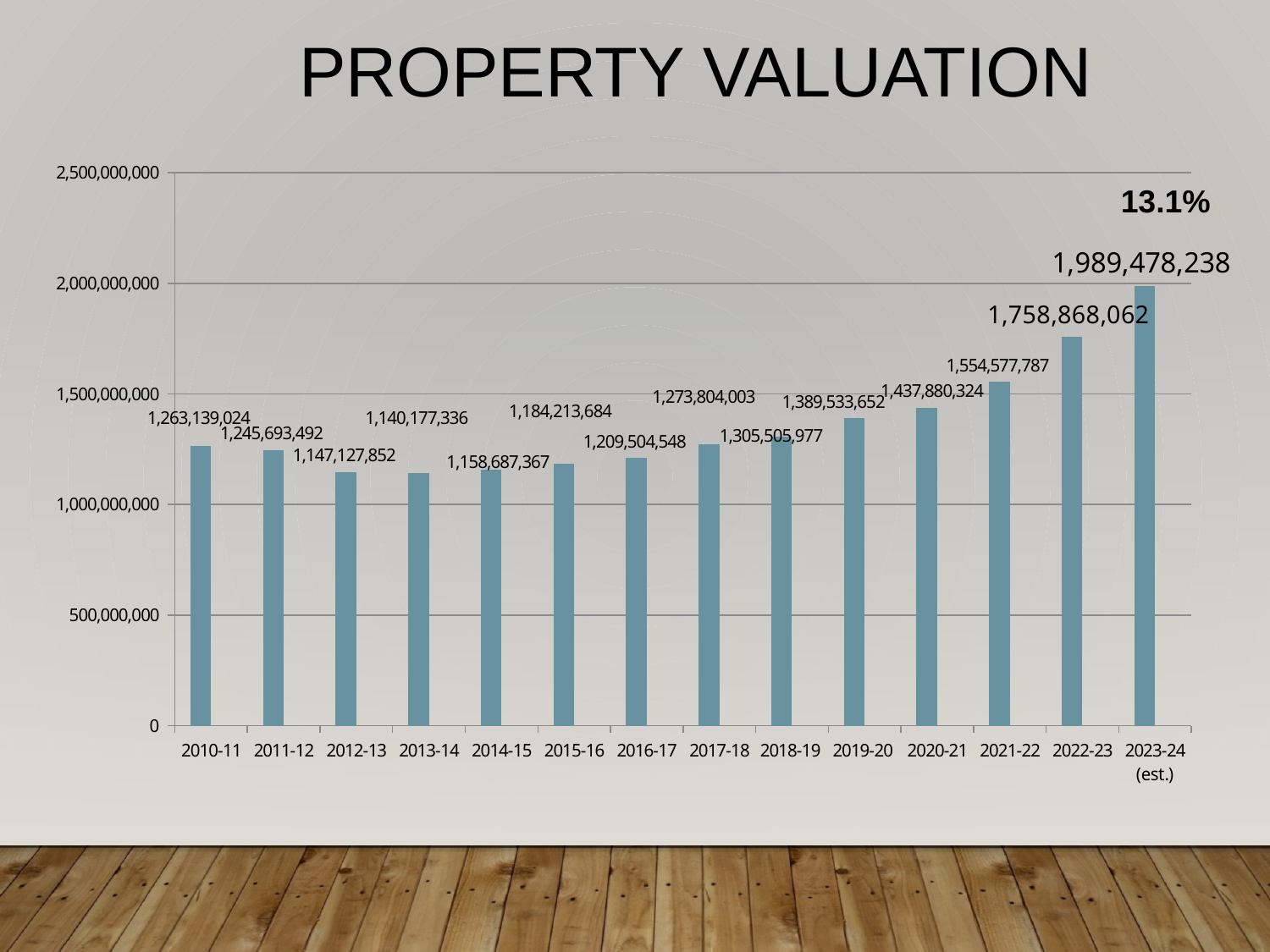
Which is larger, the valuation for 2011-12 or for 2012-13? 2011-12 How many years are shown on the x axis? 14 Which year has the highest property valuation? 2023-24 (est.) What percentage is annotated at the top right of the chart? 13.1% Which year has the lowest property valuation? 2013-14 What is the estimated property valuation for 2023-24? 1,989,478,238 What is the property valuation for 2017-18? 1,273,804,003 What is the property valuation for 2022-23? 1,758,868,062 What is the difference between the 2023-24 (est.) valuation and the 2022-23 valuation? 230,610,176 What is the property valuation for 2010-11? 1,263,139,024 What kind of chart is shown on the slide? Bar chart Is the value for 2021-22 greater or less than 1,500,000,000? greater